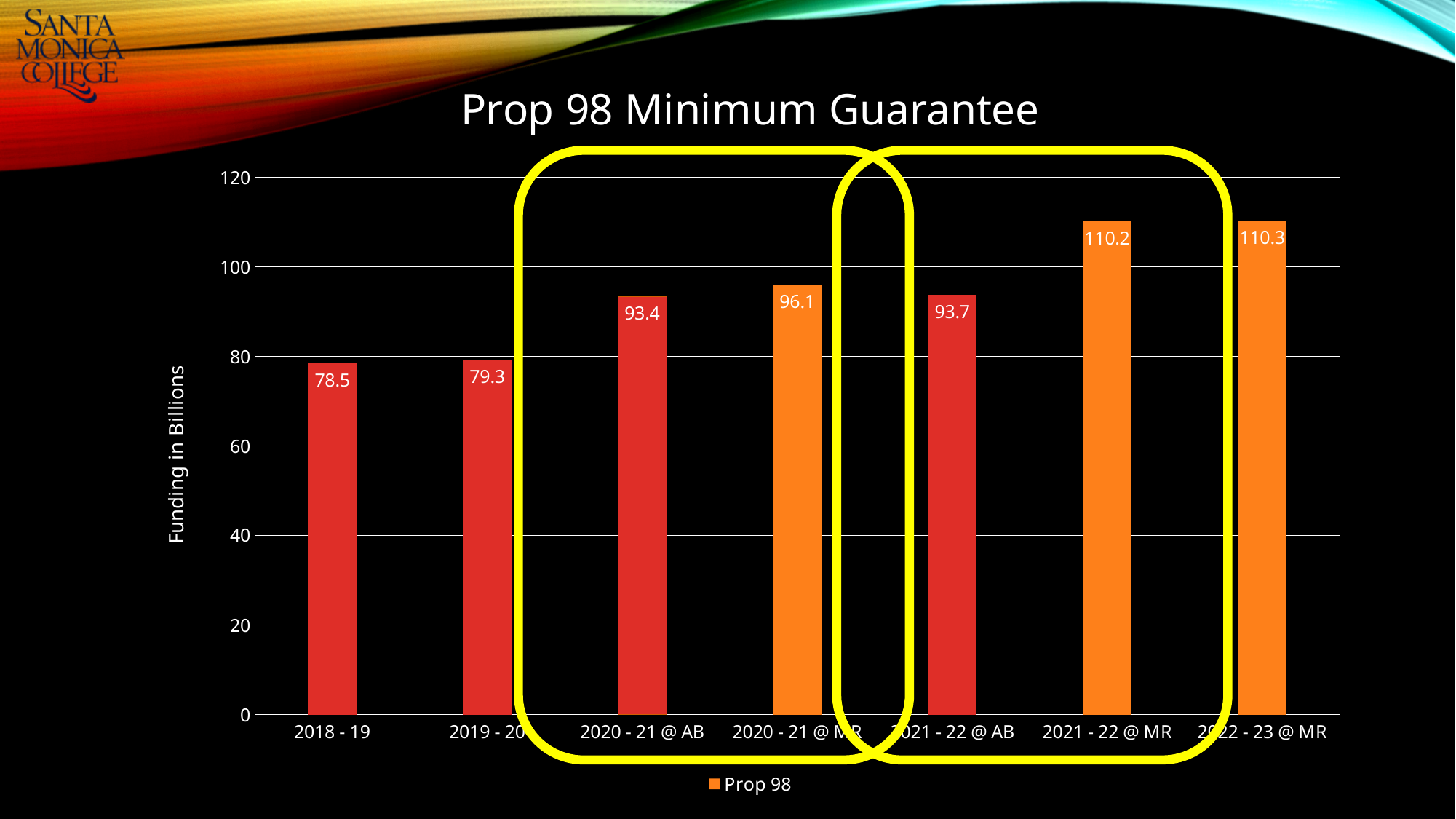
How many categories are shown on the x axis? 7 What is the value for 2020 - 21 @ MR? 96.1 Which is larger, the value for 2019 - 20 or the value for 2021 - 22 @ AB? 2021 - 22 @ AB What is the value for 2022 - 23 @ MR? 110.3 What is the value for 2021 - 22 @ MR? 110.2 What is the label of the y axis? Funding in Billions What is the difference between the values for 2021 - 22 @ MR and 2021 - 22 @ AB? 16.5 What kind of chart is shown on the slide? bar chart What is the difference between the values for 2020 - 21 @ MR and 2020 - 21 @ AB? 2.7 Is the value for 2021 - 22 @ MR greater or less than 100? greater What is the value for 2018 - 19? 78.5 Which category has the lowest value? 2018 - 19